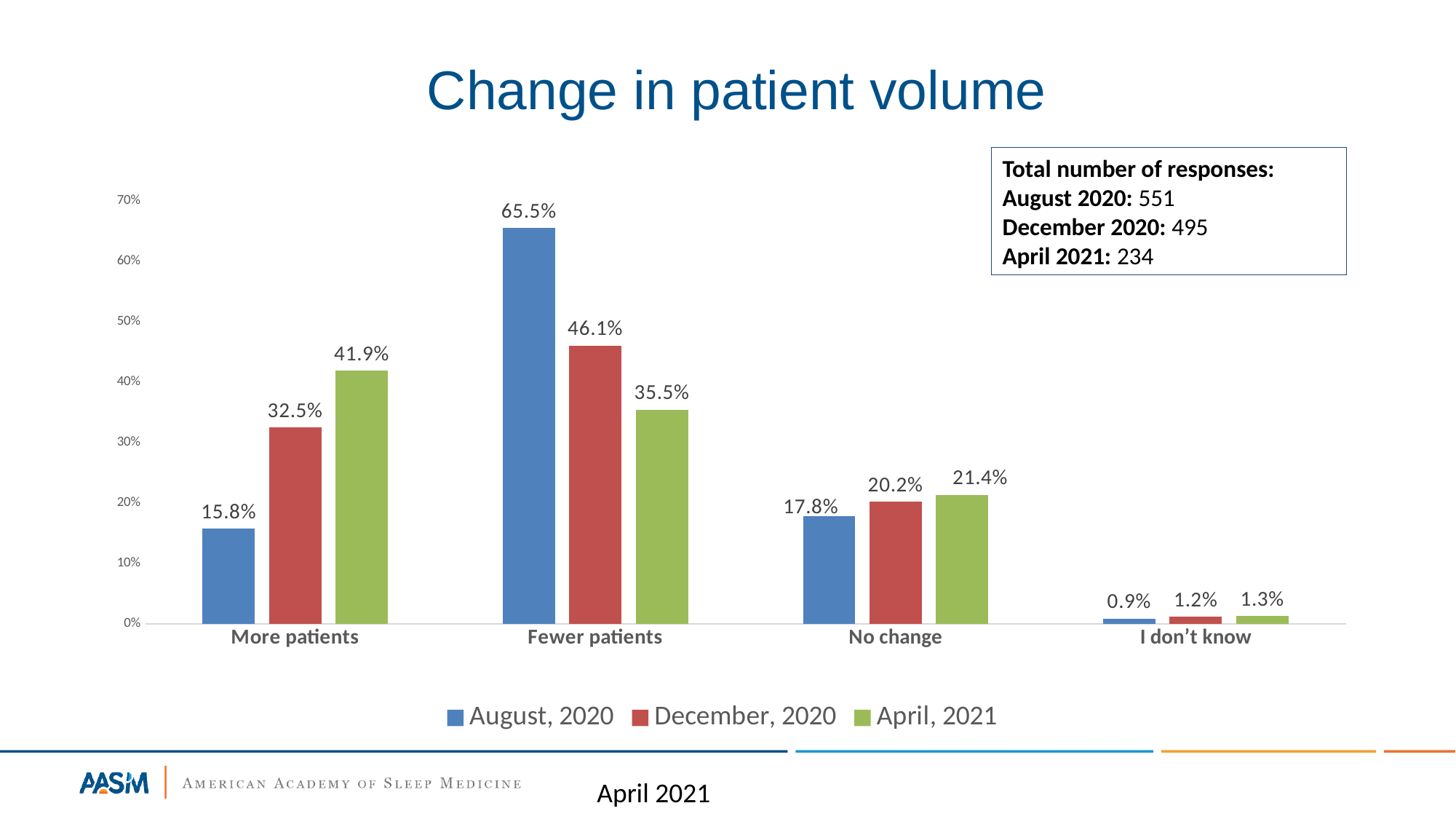
What is the value for No change in the December, 2020 series? 20.2% What is the difference between the August, 2020 and April, 2021 values for Fewer patients? 30 percentage points How many categories are shown on the x axis? 4 Which is larger for No change: the August, 2020 value or the April, 2021 value? April, 2021 How many series does the legend list? 3 Is the December, 2020 value for Fewer patients greater or less than 40%? greater Which category has the lowest value in the April, 2021 series? I don't know What is the value for Fewer patients in the August, 2020 series? 65.5% Which category has the highest value in the August, 2020 series? Fewer patients What kind of chart is shown on the slide? bar chart What is the value for More patients in the April, 2021 series? 41.9% What is the difference between the April, 2021 and August, 2020 values for More patients? 26.1 percentage points